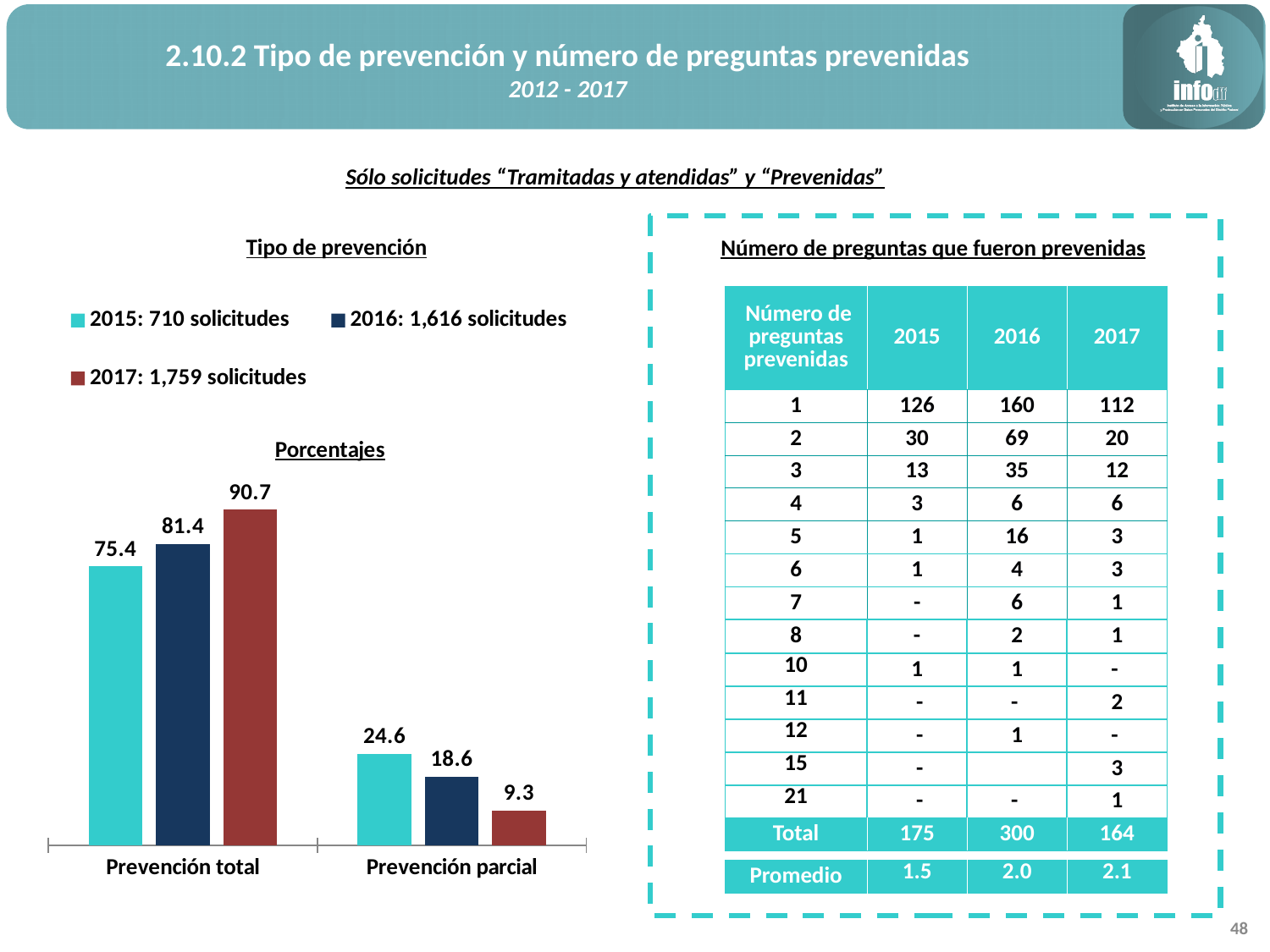
In the 'Tipo de prevención' bar chart, which year has the highest value for 'Prevención total'? 2017 In the 'Tipo de prevención' bar chart, what is the value for 2017 in the 'Prevención total' category? 90.7 In the 'Tipo de prevención' bar chart, which year has the lowest value for 'Prevención parcial'? 2017 In the 'Tipo de prevención' bar chart, what is the value for 2015 in the 'Prevención parcial' category? 24.6 In the 'Tipo de prevención' bar chart, what is the value for 2016 in the 'Prevención total' category? 81.4 In the 'Tipo de prevención' bar chart, which is larger: the 2016 value for 'Prevención parcial' or the 2017 value for 'Prevención parcial'? 2016 In the 'Tipo de prevención' bar chart, what is the difference between the 2017 and 2015 values for 'Prevención total'? 15.3 In the 'Tipo de prevención' bar chart, what is the difference between the 2015 and 2016 values for 'Prevención parcial'? 6.0 According to the legend of the 'Tipo de prevención' chart, how many solicitudes does the 2016 series represent? 1,616 solicitudes What kind of chart is the 'Tipo de prevención' chart? Bar chart How many categories are shown on the x axis of the 'Tipo de prevención' bar chart? 2 How many series does the legend of the 'Tipo de prevención' chart list? 3